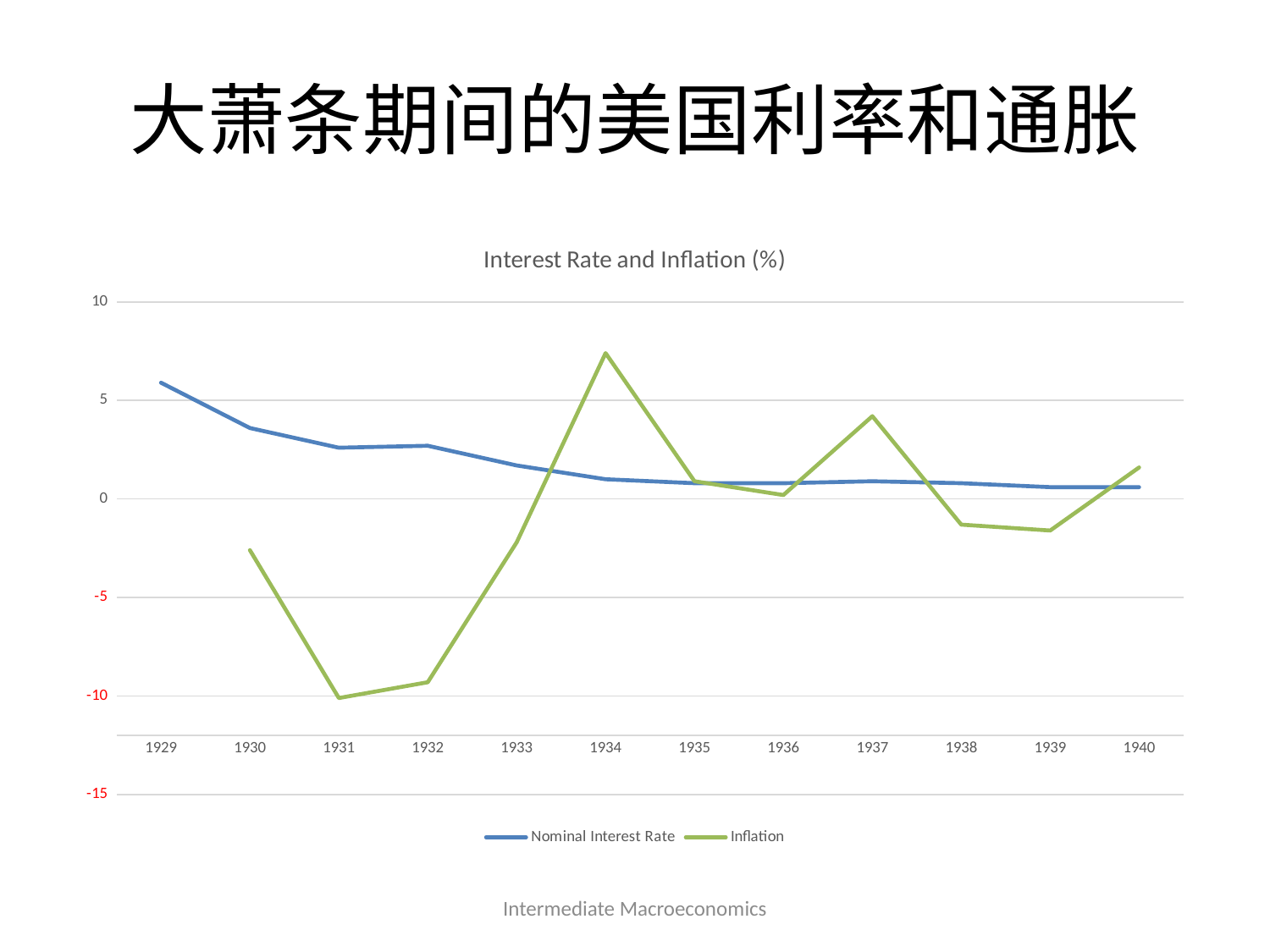
Is the Nominal Interest Rate for 1929 greater or less than 5? greater What kind of chart is shown on the slide? line chart In which year is the Nominal Interest Rate highest? 1929 Is the Inflation value for 1934 greater or less than 5? greater Which series is drawn in green? Inflation How many series does the legend list? 2 How many years are plotted along the x axis? 12 Does the Nominal Interest Rate generally rise or fall from 1929 to 1940? fall In 1931, which is larger: the Nominal Interest Rate or Inflation? Nominal Interest Rate What is the title of the chart? Interest Rate and Inflation (%) In which year is Inflation highest? 1934 Is the Inflation value for 1931 greater or less than -5? less